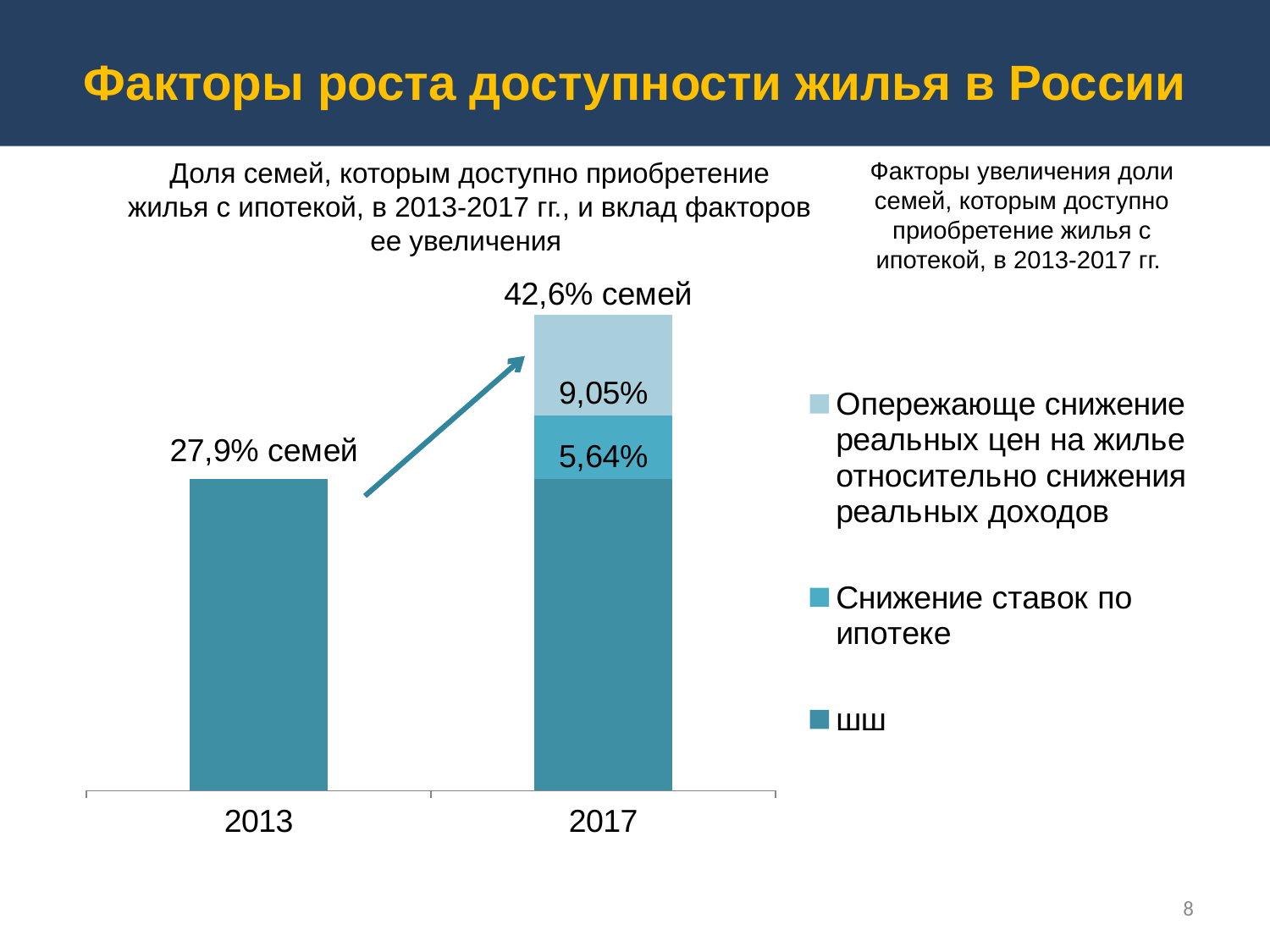
Does the share of families rise or fall from 2013 to 2017? Rises What kind of chart is shown on the slide? Stacked bar chart What is the contribution of 'Снижение ставок по ипотеке' shown in the 2017 bar? 5,64% Which factor contributed more to the 2017 increase: 'Опережающе снижение реальных цен на жилье' or 'Снижение ставок по ипотеке'? Опережающе снижение реальных цен на жилье относительно снижения реальных доходов By how many percentage points did the share of families grow from 2013 (27,9%) to 2017 (42,6%)? 14,7 What share of families could afford buying housing with a mortgage in 2017, according to the chart? 42,6% семей Which year has the higher share of families in the chart? 2017 What is the contribution of 'Опережающе снижение реальных цен на жилье относительно снижения реальных доходов' shown in the 2017 bar? 9,05% How many years (categories) are shown on the x axis of the chart? 2 How many series does the legend of the chart list? 3 What is the difference between the 9,05% and 5,64% contributions in the 2017 bar? 3,41 What share of families could afford buying housing with a mortgage in 2013, according to the chart? 27,9% семей